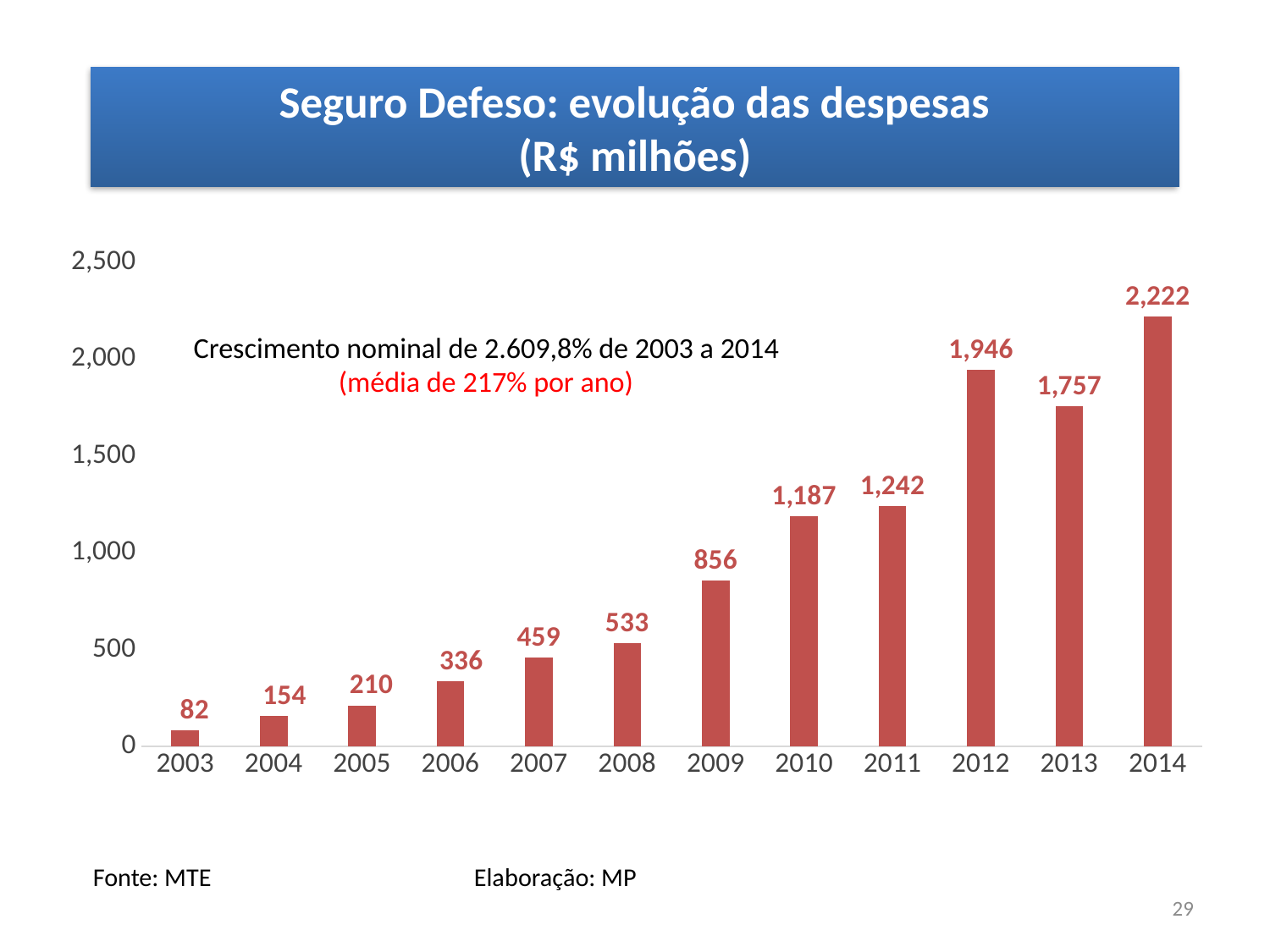
What is the difference between the values for 2014 and 2013? 465 Is the value for 2010 greater or less than 1,000? greater Which year has the lowest value? 2003 What kind of chart is shown on the slide? bar chart What is the difference between the values for 2012 and 2011? 704 What is the value for 2003? 82 How many years are shown on the x axis? 12 Which year has the highest value? 2014 What is the value for 2013? 1,757 What is the value for 2009? 856 Do the values generally rise or fall from 2003 to 2012? rise Which is larger, the value for 2012 or the value for 2013? 2012